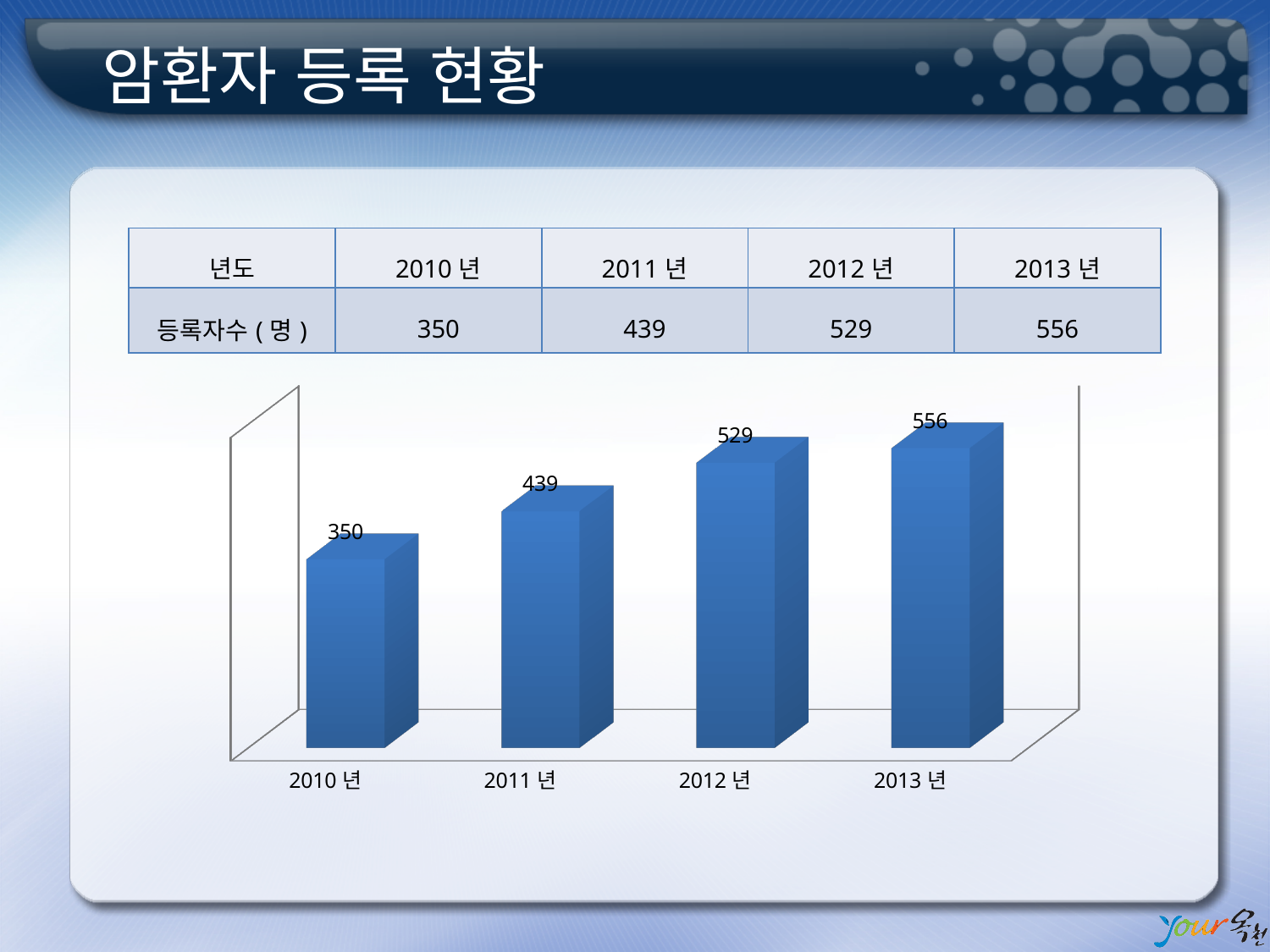
What is the difference between the values for 2012 년 and 2011 년? 90 What is the value for 2010 년? 350 How many categories are shown on the x axis? 4 What kind of chart is shown? bar chart Which year has the highest value? 2013 년 Which year has the lowest value? 2010 년 What is the value for 2013 년? 556 What is the difference between the values for 2013 년 and 2010 년? 206 What is the value for 2012 년? 529 Do the values rise or fall from 2010 년 to 2013 년? rise What is the value for 2011 년? 439 Which is larger, the value for 2011 년 or the value for 2012 년? 2012 년